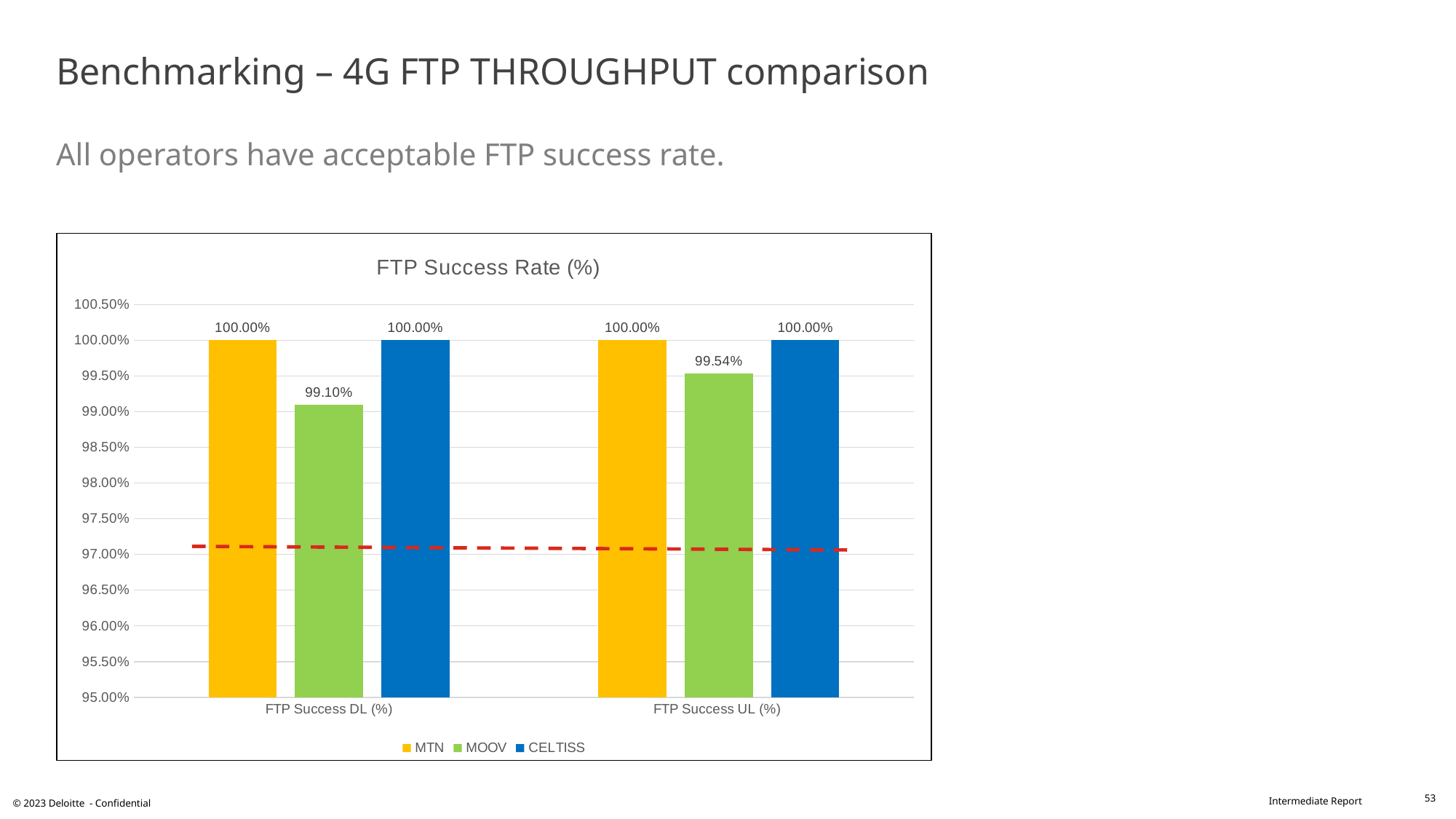
What is the title of the chart? FTP Success Rate (%) What is the FTP Success DL (%) value for MTN? 100.00% Is MOOV's FTP Success DL (%) value greater or less than 99.50%? less What is the difference between MOOV's FTP Success UL (%) and FTP Success DL (%)? 0.44% Which operator has the lowest FTP Success DL (%)? MOOV What is the FTP Success UL (%) value for MOOV? 99.54% What is the FTP Success UL (%) value for CELTISS? 100.00% How many series does the legend list? 3 What is the difference between MTN and MOOV for FTP Success DL (%)? 0.90% Which operator has the lowest FTP Success UL (%)? MOOV What is the FTP Success DL (%) value for MOOV? 99.10% What kind of chart is shown on the slide? Bar chart